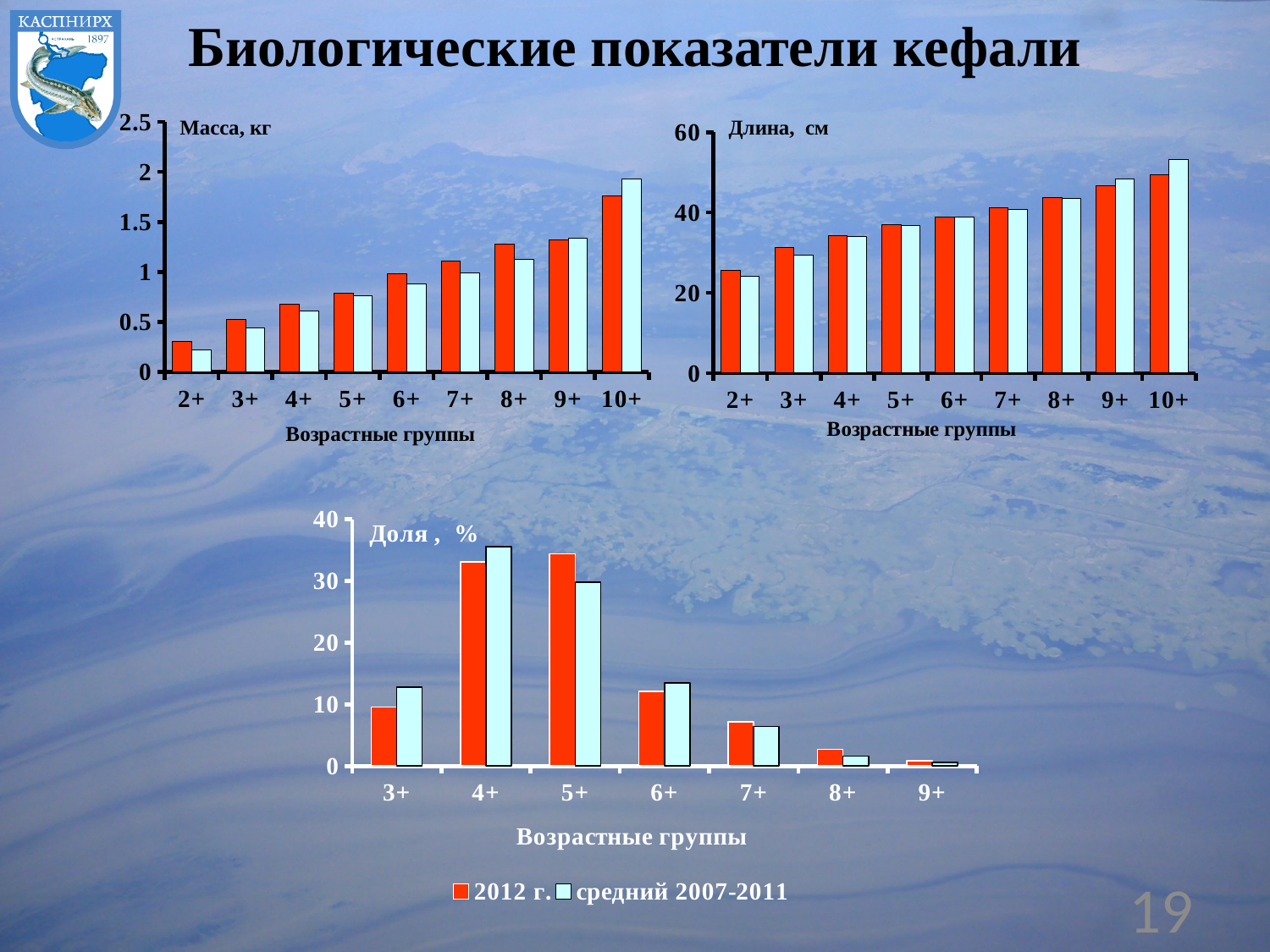
In the "Длина, см" chart, is the средний 2007-2011 value for age group 10+ greater or less than 40? greater In the "Длина, см" chart, is the 2012 г. value for age group 2+ greater or less than 20? greater In the "Масса, кг" chart, is the 2012 г. value for age group 10+ greater or less than 1.5? greater How many series does the legend at the bottom of the slide list? 2 How many age groups are shown on the x axis of the "Доля, %" chart at the bottom of the slide? 7 In the "Масса, кг" chart, which age group has the highest values? 10+ What kind of chart is the "Масса, кг" chart at the top left of the slide? bar chart In the "Доля, %" chart, for age group 5+, which series has the larger value: 2012 г. or средний 2007-2011? 2012 г. In the "Длина, см" chart, which age group has the lowest values? 2+ In the "Доля, %" chart, which age group has the highest средний 2007-2011 value? 4+ How many age groups are shown on the x axis of the "Масса, кг" chart? 9 In the "Масса, кг" chart, do the values rise or fall as the age group increases along the x axis? rise